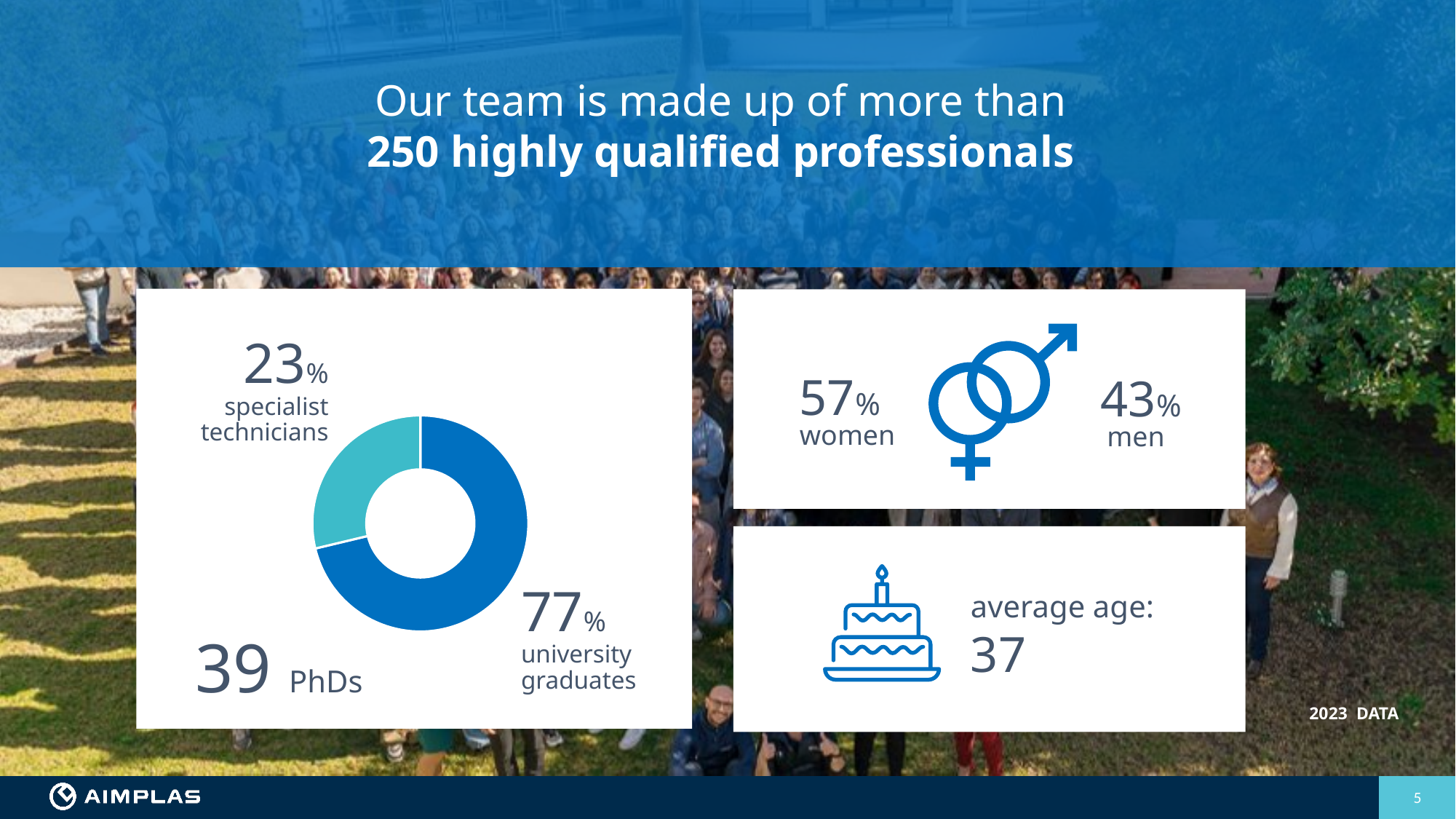
What do the two slices of the donut chart add up to? 100% What colour is the specialist technicians slice of the donut chart? Teal (light blue-green) What is the difference in percentage points between university graduates and specialist technicians in the donut chart? 54 How many slices does the donut chart have? 2 Which slice of the donut chart is the largest? university graduates Which is larger in the donut chart: the share of university graduates or the share of specialist technicians? university graduates Is the share of specialist technicians in the donut chart greater or less than 50%? less What colour is the university graduates slice of the donut chart? Dark blue What share of the team are university graduates according to the donut chart? 77% What kind of chart is shown on the slide? Donut (pie) chart What share of the team are specialist technicians according to the donut chart? 23% Which slice of the donut chart is the smallest? specialist technicians